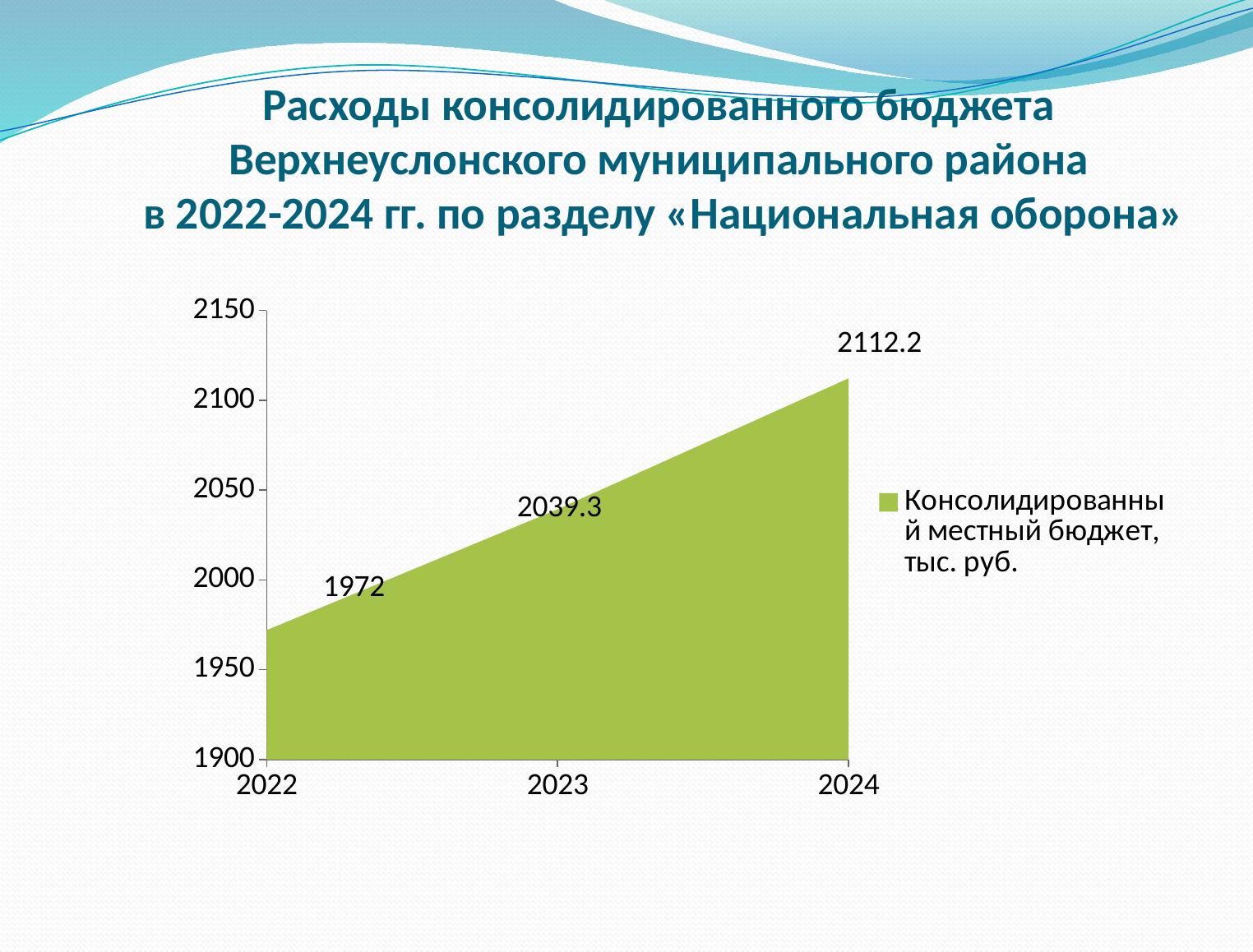
How many years are plotted on the chart? 3 What is the difference between the values for 2023 and 2022? 67.3 What is the value for 2024? 2112.2 Which is larger, the value for 2023 or the value for 2024? 2024 What kind of chart is shown on the slide? area chart Do the values rise or fall from 2022 to 2024? rise Which year has the lowest value? 2022 Is the value for 2024 greater or less than 2100? greater Which year has the highest value? 2024 What is the value for 2022? 1972 What is the value for 2023? 2039.3 What is the difference between the values for 2024 and 2022? 140.2